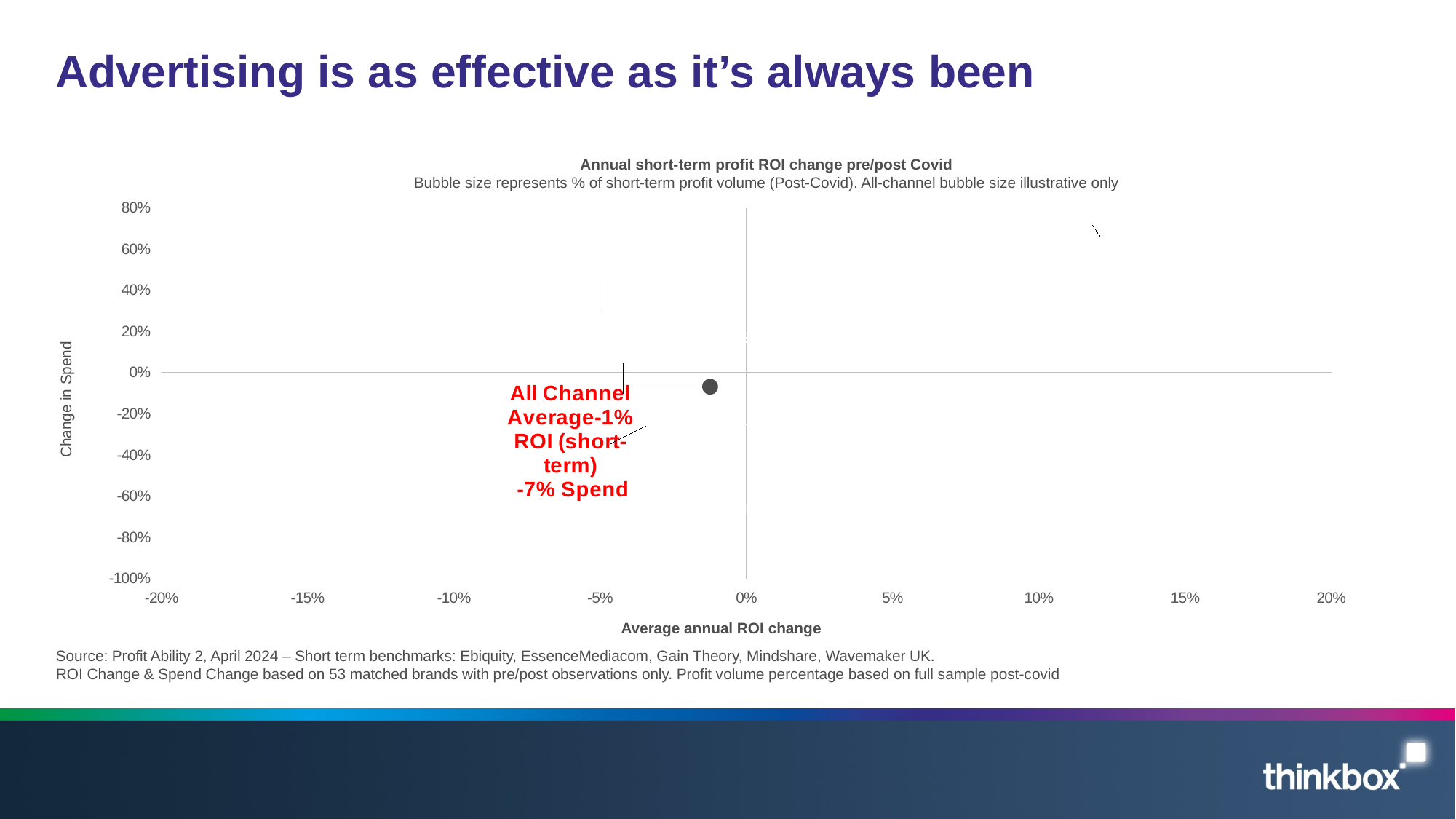
Is the All Channel Average change in spend greater or less than -20%? greater What is the average annual ROI change for the All Channel Average bubble? -1% What kind of chart is shown on the slide? Bubble chart What is the label of the horizontal axis? Average annual ROI change Is the All Channel Average change in spend greater or less than 0%? less How many labelled bubbles are plotted on the chart? 1 What is the title of the chart? Annual short-term profit ROI change pre/post Covid What is the change in spend for the All Channel Average bubble? -7% Is the All Channel Average ROI change greater or less than 0%? less